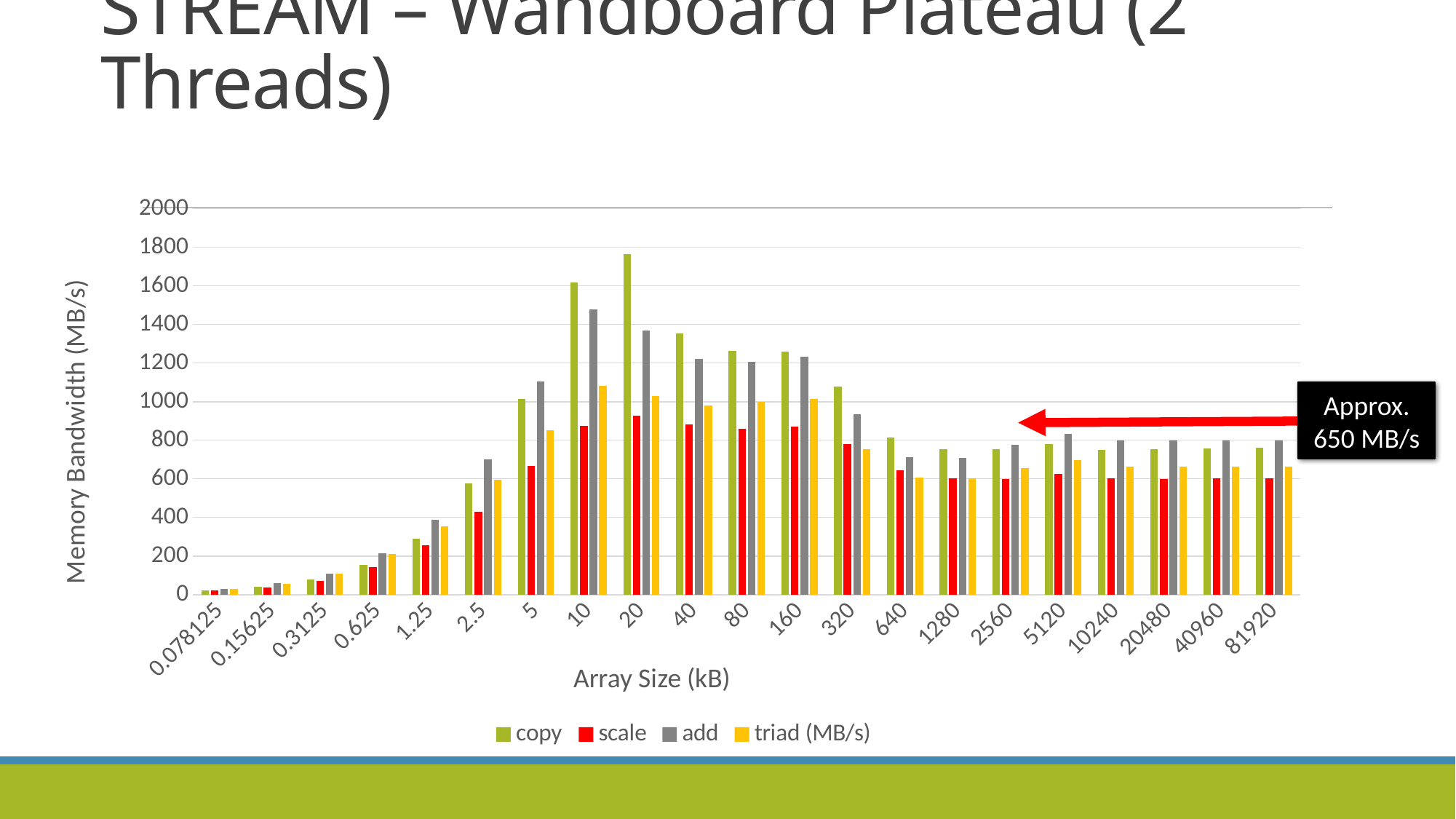
At which array size is the copy bandwidth lowest? 0.078125 At array size 5, which is larger, add or triad? add At array size 20, which is larger, copy or scale? copy Is the triad value at array size 81920 greater or less than 600? greater At which array size is the copy bandwidth highest? 20 Is the scale value at array size 20 greater or less than 1000? less What kind of chart is shown on the slide? bar chart Is the add value at array size 10 greater or less than 1400? greater Does the copy bandwidth rise or fall from array size 20 to array size 320? fall How many array size categories are shown on the x axis? 21 How many series does the legend list? 4